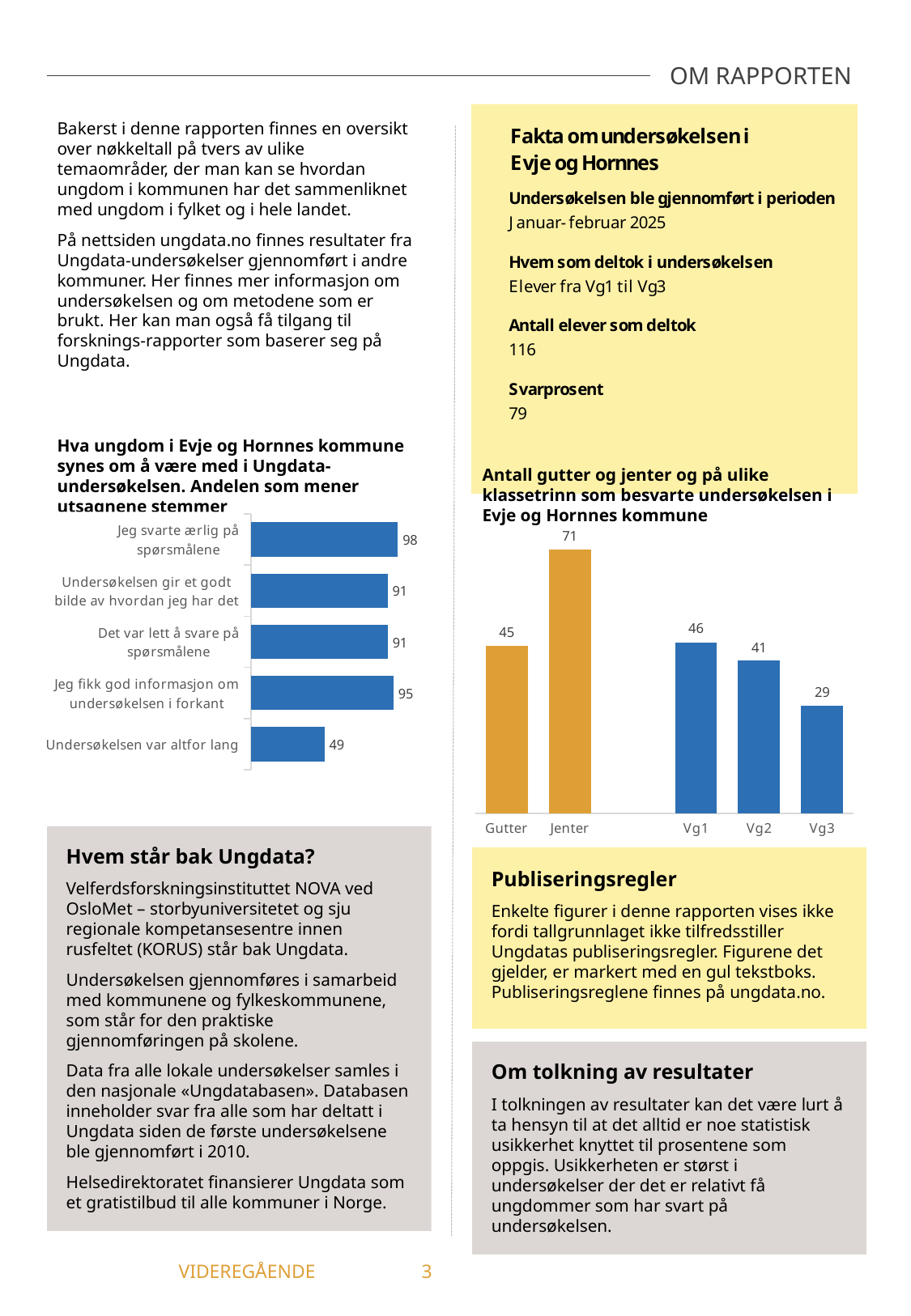
In the chart 'Antall gutter og jenter og på ulike klassetrinn som besvarte undersøkelsen', what is the difference between Jenter and Gutter? 26 What type of chart is 'Hva ungdom i Evje og Hornnes kommune synes om å være med i Ungdata-undersøkelsen'? Bar chart In the chart 'Antall gutter og jenter og på ulike klassetrinn som besvarte undersøkelsen', which category has the highest value? Jenter In the chart 'Hva ungdom i Evje og Hornnes kommune synes om å være med i Ungdata-undersøkelsen', what is the value for 'Undersøkelsen var altfor lang'? 49 In the chart 'Hva ungdom i Evje og Hornnes kommune synes om å være med i Ungdata-undersøkelsen', which statement has the lowest value? Undersøkelsen var altfor lang In the chart 'Antall gutter og jenter og på ulike klassetrinn som besvarte undersøkelsen', what is the value for Vg3? 29 In the chart 'Hva ungdom i Evje og Hornnes kommune synes om å være med i Ungdata-undersøkelsen', what is the difference between 'Jeg fikk god informasjon om undersøkelsen i forkant' and 'Undersøkelsen var altfor lang'? 46 How many statements are shown in the chart 'Hva ungdom i Evje og Hornnes kommune synes om å være med i Ungdata-undersøkelsen'? 5 In the chart 'Hva ungdom i Evje og Hornnes kommune synes om å være med i Ungdata-undersøkelsen', which statement has the highest value? Jeg svarte ærlig på spørsmålene In the chart 'Hva ungdom i Evje og Hornnes kommune synes om å være med i Ungdata-undersøkelsen', what is the value for 'Jeg svarte ærlig på spørsmålene'? 98 In the chart 'Antall gutter og jenter og på ulike klassetrinn som besvarte undersøkelsen', do the values rise or fall from Vg1 to Vg3? Fall In the chart 'Antall gutter og jenter og på ulike klassetrinn som besvarte undersøkelsen', how many Jenter answered? 71